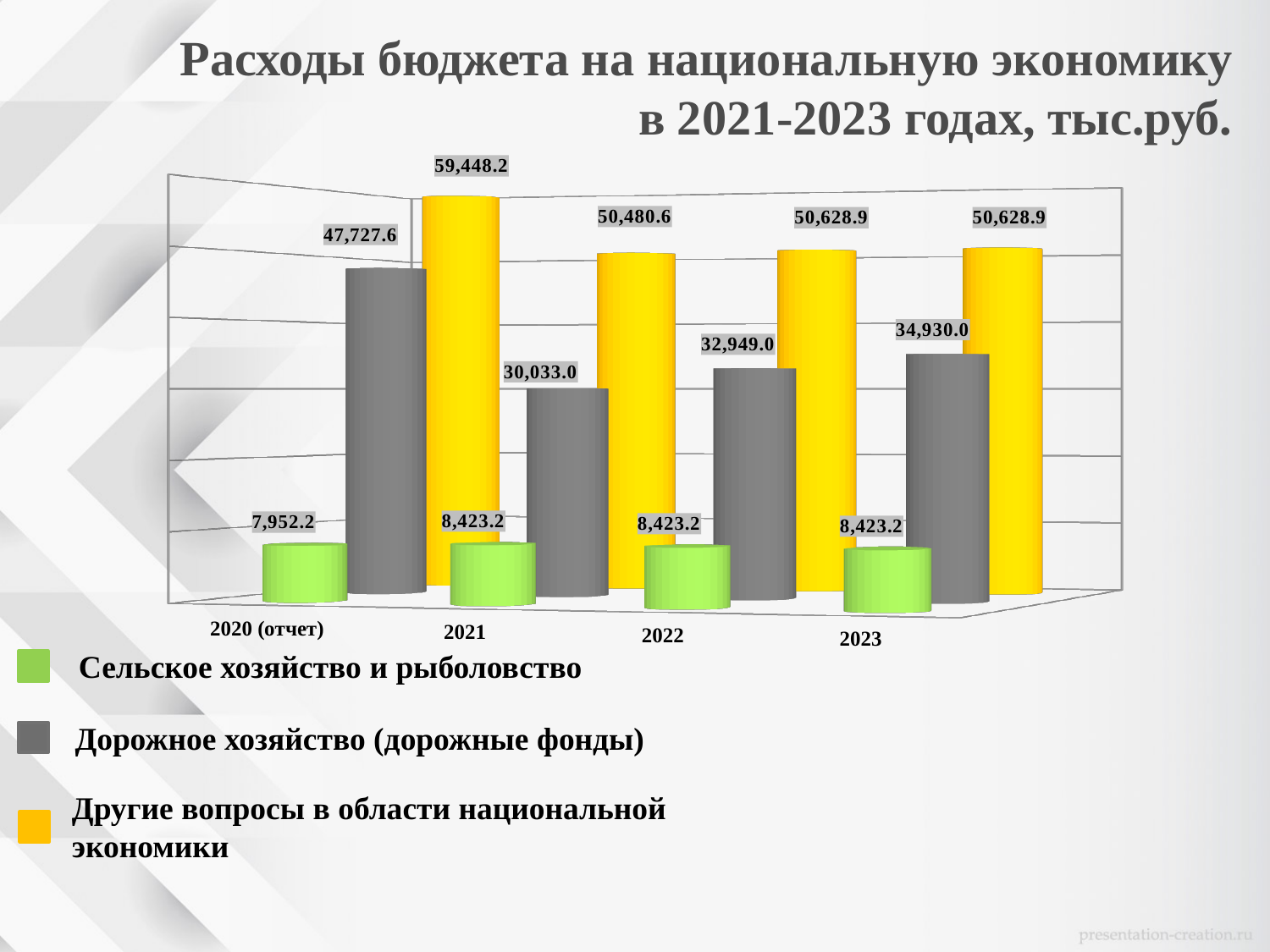
What is the value for Дорожное хозяйство (дорожные фонды) in 2021? 30,033.0 How many years are shown on the x axis? 4 What is the difference between the Другие вопросы в области национальной экономики values for 2020 (отчет) and 2021? 8,967.6 Which is larger: Дорожное хозяйство (дорожные фонды) in 2020 (отчет) or in 2023? 2020 (отчет) How many series does the legend list? 3 Does the value for Дорожное хозяйство (дорожные фонды) rise or fall from 2021 to 2023? Rise In which year is the value for Дорожное хозяйство (дорожные фонды) highest? 2020 (отчет) What kind of chart is shown on the slide? Bar chart What is the value for Сельское хозяйство и рыболовство in 2023? 8,423.2 What is the value for Другие вопросы в области национальной экономики in 2020 (отчет)? 59,448.2 In which year is the value for Дорожное хозяйство (дорожные фонды) lowest? 2021 What is the difference between the Дорожное хозяйство (дорожные фонды) values for 2023 and 2022? 1,981.0